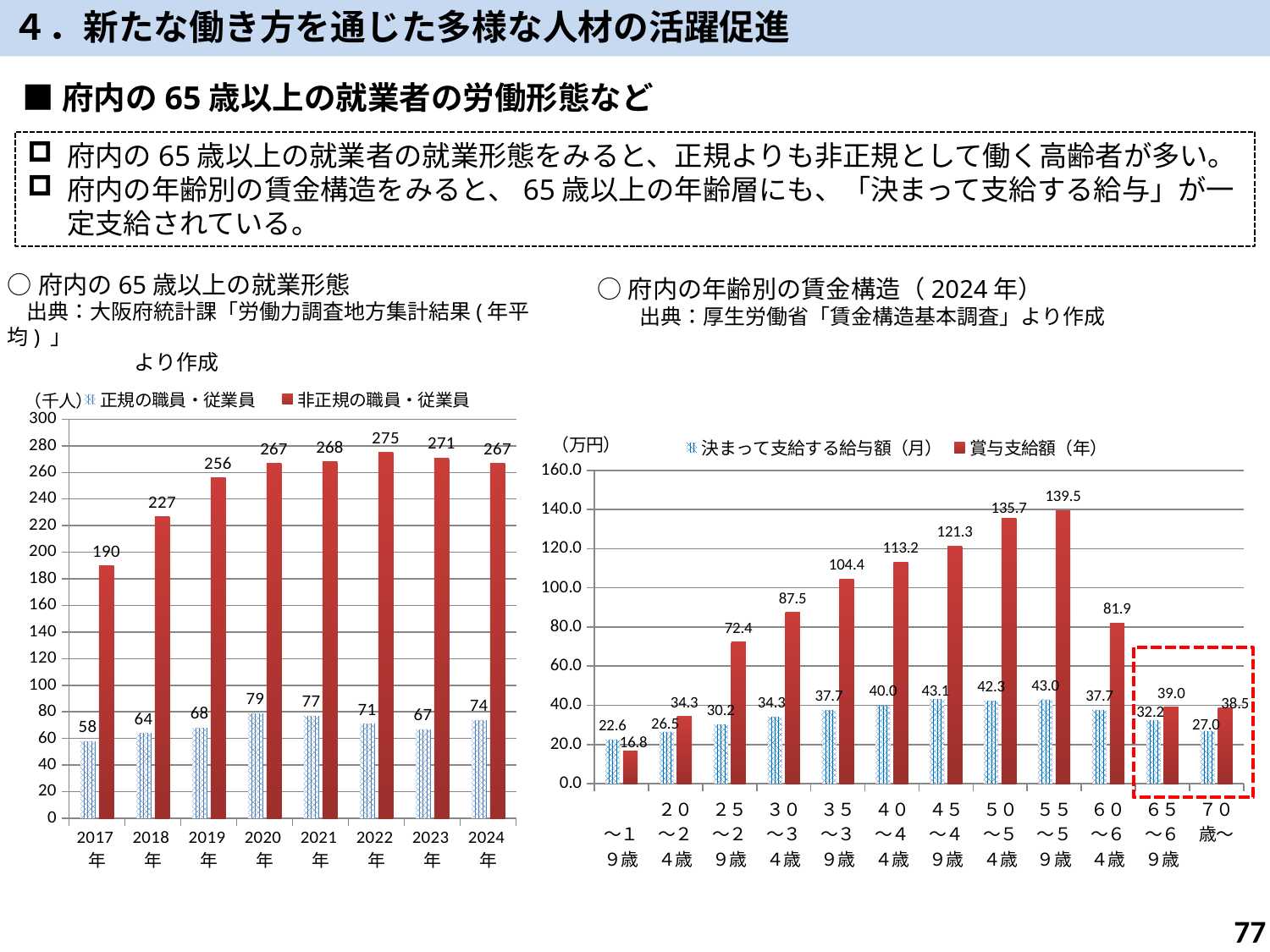
左のグラフ「府内の65歳以上の就業形態」で、正規の職員・従業員が最も少ない年はどれですか？ 2017年 右のグラフ「府内の年齢別の賃金構造（2024年）」の凡例には系列がいくつありますか？ 2 左のグラフ「府内の65歳以上の就業形態」には何年分のデータがありますか？ 8 左のグラフ「府内の65歳以上の就業形態」で、2017年から2019年にかけて非正規の職員・従業員は増加していますか、減少していますか？ 増加 右のグラフ「府内の年齢別の賃金構造（2024年）」で、65～69歳の賞与支給額（年）と70歳～の賞与支給額（年）ではどちらが大きいですか？ 65～69歳 左のグラフ「府内の65歳以上の就業形態」で、2022年の非正規の職員・従業員の値はいくつですか？ 275 左のグラフ「府内の65歳以上の就業形態」で、2024年の非正規と正規の職員・従業員の差はいくつですか？ 193 右のグラフ「府内の年齢別の賃金構造（2024年）」で、決まって支給する給与額（月）が最も高い年齢層はどれですか？ 45～49歳 右のグラフ「府内の年齢別の賃金構造（2024年）」で、賞与支給額（年）が最も低い年齢層はどれですか？ ～19歳 右のグラフ「府内の年齢別の賃金構造（2024年）」で、55～59歳の賞与支給額（年）はいくつですか？ 139.5 左のグラフ「府内の65歳以上の就業形態」で、非正規の職員・従業員が最も多い年はどれですか？ 2022年 左のグラフ「府内の65歳以上の就業形態」で、2017年の正規の職員・従業員の値はいくつですか？ 58